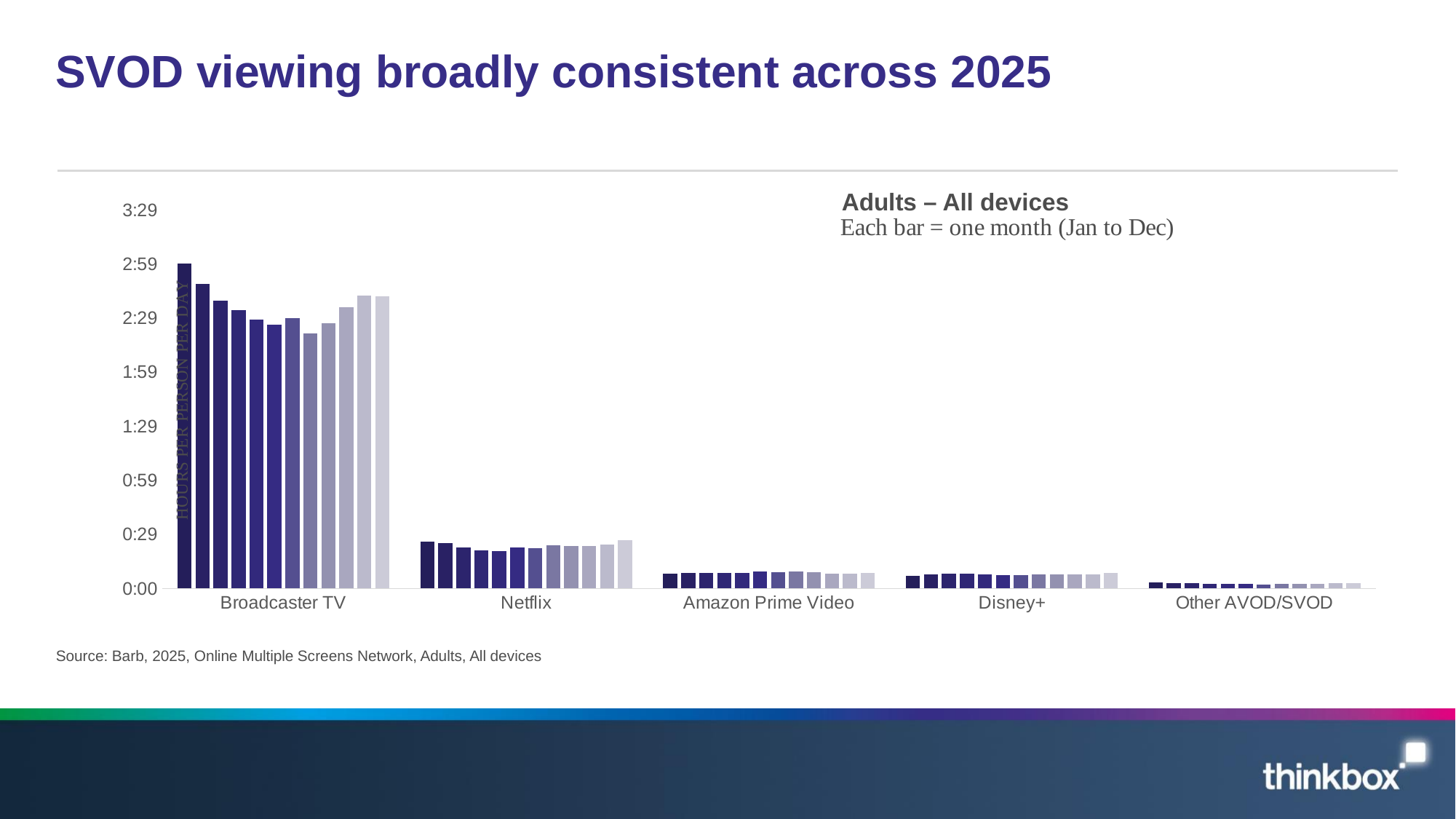
Is the value for the first (January) Broadcaster TV bar greater or less than 2:29? greater Which category has the highest viewing values in the chart? Broadcaster TV Which category has the lowest viewing values in the chart? Other AVOD/SVOD Which category has higher values, Amazon Prime Video or Other AVOD/SVOD? Amazon Prime Video What does each bar in the chart represent, according to the annotation? One month (Jan to Dec) Are the Netflix bars greater or less than 0:29? less How many bars are plotted for each category in the chart? 12 Which category has higher values, Netflix or Disney+? Netflix Is the value for the first (January) Broadcaster TV bar greater or less than 3:29? less What kind of chart is shown on the slide? Bar chart How many categories are shown along the x axis of the chart? 5